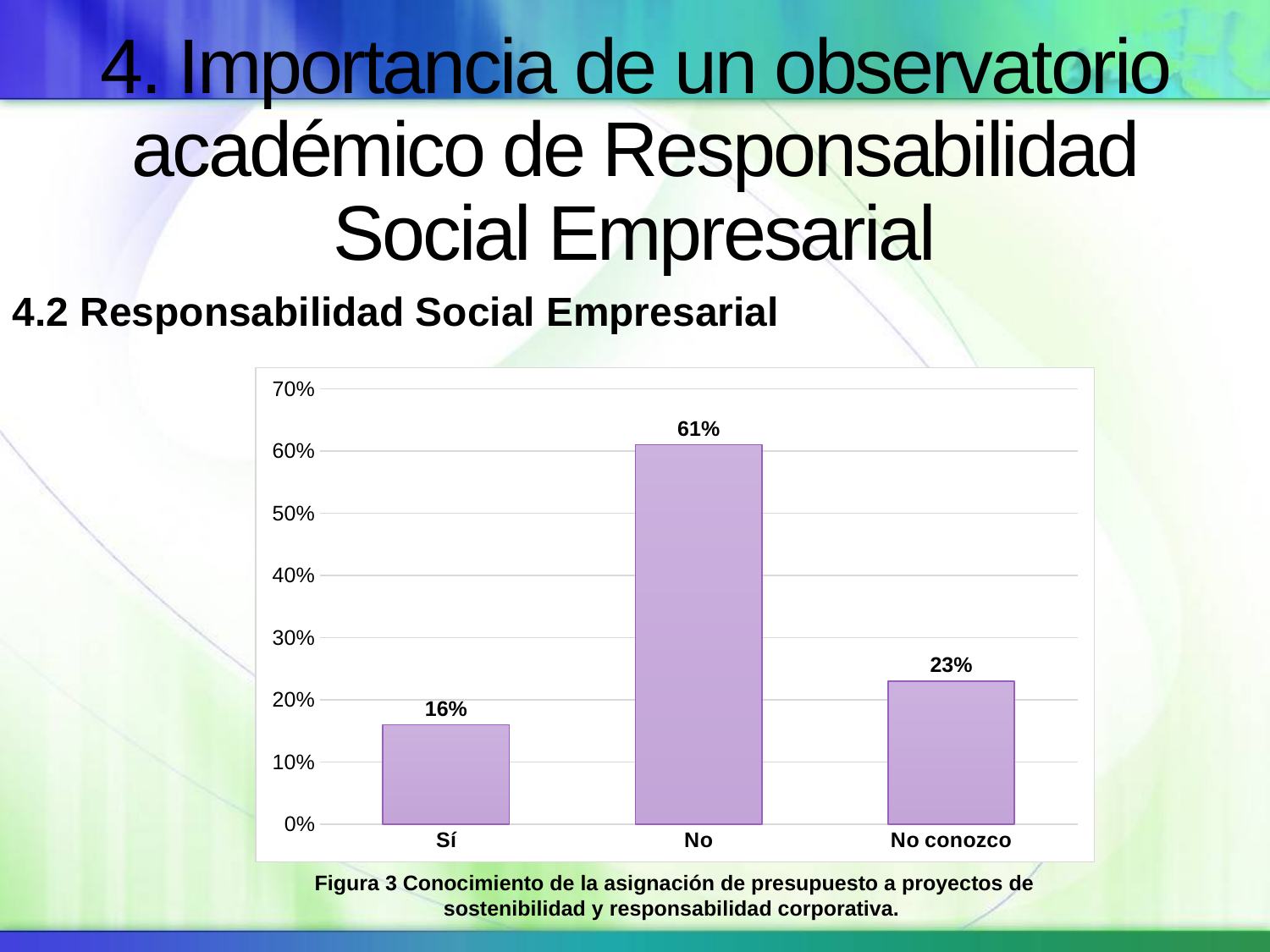
How many categories are shown on the x axis? 3 What is the difference between the values for "No conozco" and "Sí"? 7% What is the figure caption below the chart? Figura 3 Conocimiento de la asignación de presupuesto a proyectos de sostenibilidad y responsabilidad corporativa. What is the value for "No"? 61% Which is larger, the value for "Sí" or the value for "No conozco"? No conozco Which category has the lowest value? Sí What is the value for "No conozco"? 23% What is the value for "Sí"? 16% Is the value for "No" greater or less than 50%? greater What kind of chart is shown on the slide? bar chart Which category has the highest value? No What is the difference between the values for "No" and "No conozco"? 38%